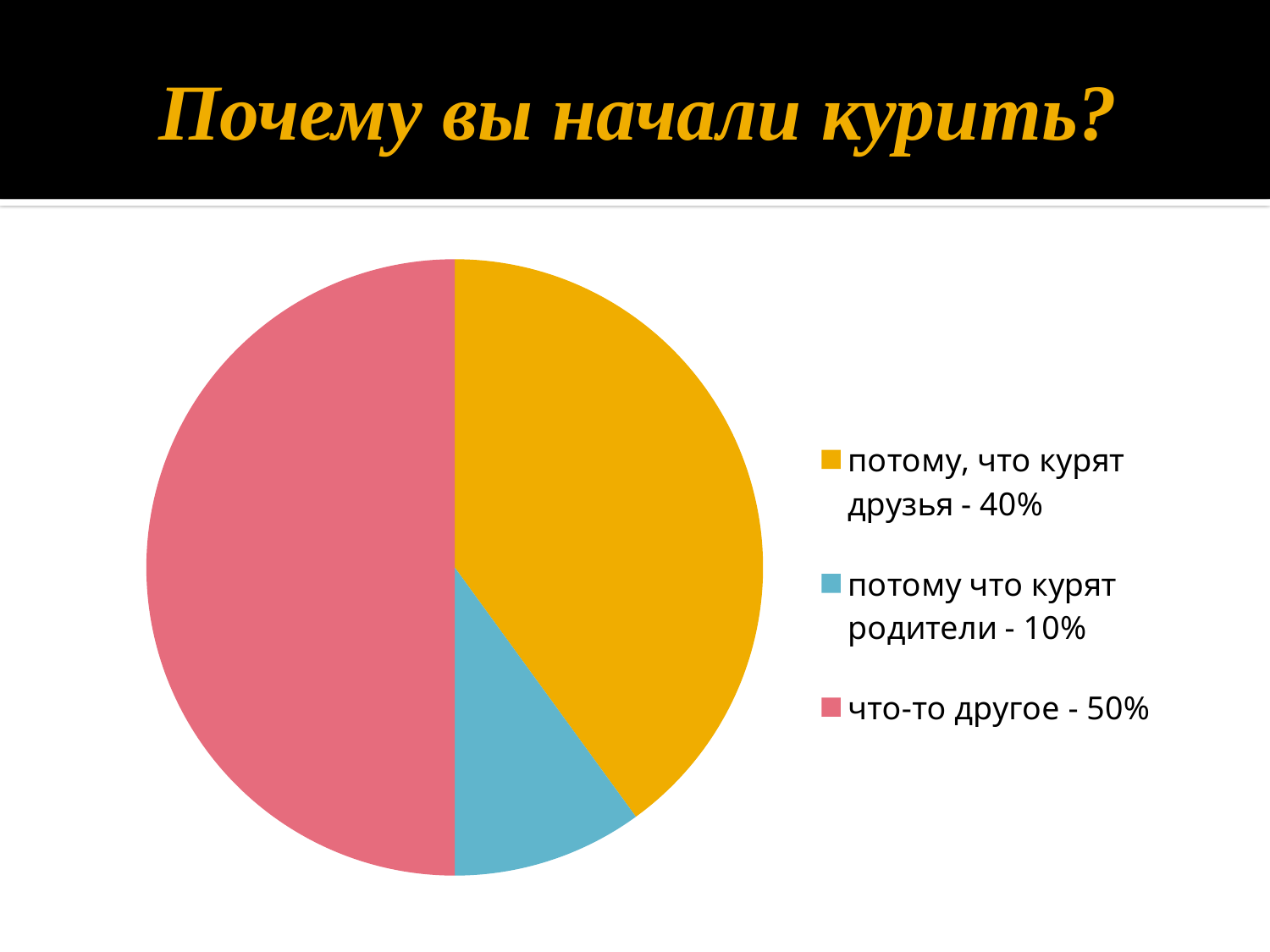
Which category has the smallest slice of the pie? потому что курят родители What is the difference in percentage points between "что-то другое" and "потому, что курят друзья"? 10 What share of the pie is labelled "что-то другое"? 50% What is the difference in percentage points between "потому, что курят друзья" and "потому что курят родители"? 30 What share of the pie is labelled "потому что курят родители"? 10% Which category has the largest slice of the pie? что-то другое How many slices does the pie chart have? 3 What share of the pie is labelled "потому, что курят друзья"? 40% What is the title of the slide containing the pie chart? Почему вы начали курить? What colour is the slice for "что-то другое"? pink Which is larger: the slice for "потому, что курят друзья" or the slice for "потому что курят родители"? потому, что курят друзья What kind of chart is shown on the slide? pie chart